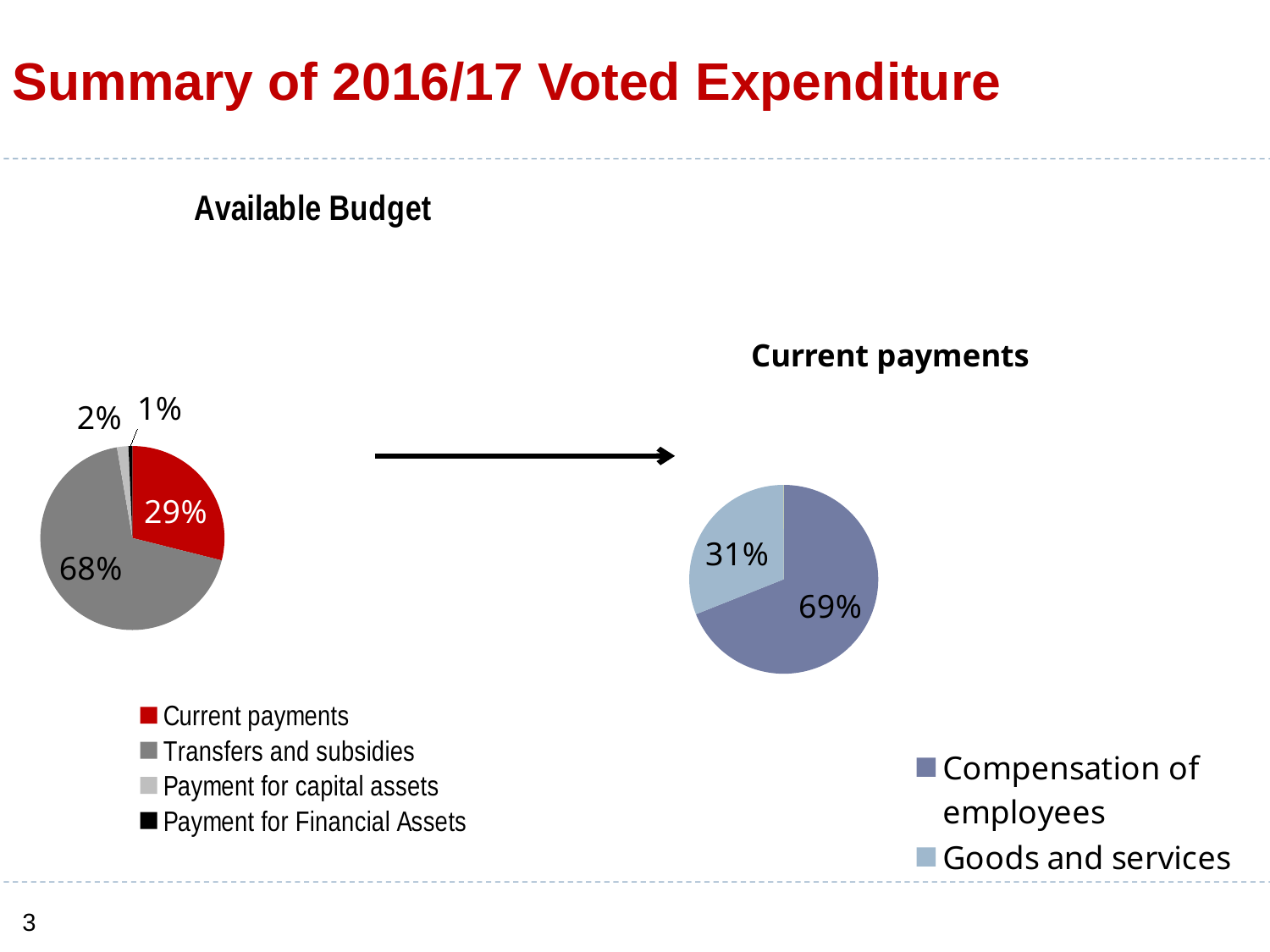
In the Current payments chart, what share is Goods and services? 31% In the Available Budget chart, which category has the largest share? Transfers and subsidies In the Available Budget chart, what share is Transfers and subsidies? 68% In the Current payments chart, which is larger: Compensation of employees or Goods and services? Compensation of employees In the Available Budget chart, what is the difference between the shares of Transfers and subsidies and Current payments? 39% In the Available Budget chart, how many categories does the legend list? 4 What kind of chart is the Current payments chart? Pie chart In the Available Budget chart, what share is Payment for capital assets? 2% In the Available Budget chart, what share is Current payments? 29% In the Available Budget chart, what share is Payment for Financial Assets? 1% In the Current payments chart, what share is Compensation of employees? 69% In the Available Budget chart, which category has the smallest share? Payment for Financial Assets